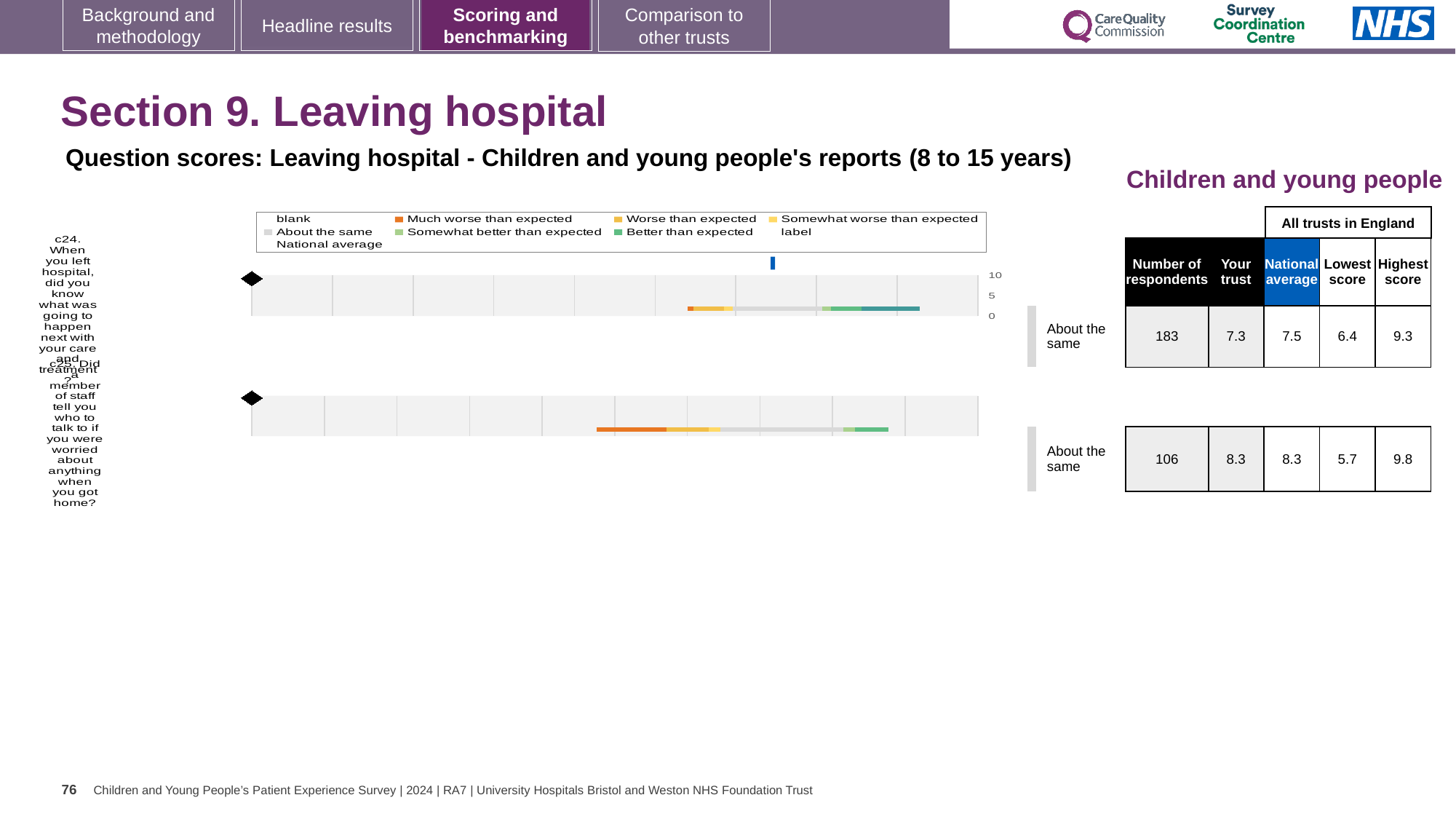
According to the table beside the chart, what is the national average for question c25 (did a member of staff tell you who to talk to if you were worried)? 8.3 According to the table beside the chart, what is the 'Your trust' score for question c24 (did you know what was going to happen next with your care and treatment)? 7.3 How many respondents answered question c24? 183 What kind of chart is used to show the question scores for Leaving hospital? bar chart What is the difference between the highest score and the lowest score for question c24? 2.9 What benchmarking category is the trust placed in for both c24 and c25? About the same How many survey questions (bars) are plotted in the Leaving hospital chart? 2 What is the difference between the highest score and the lowest score for question c25? 4.1 Which of the two questions has the higher 'Your trust' score? c25 For question c24, which is larger: the trust's score or the national average? national average How many respondents answered question c25? 106 What is the highest value shown on the chart's score axis? 10